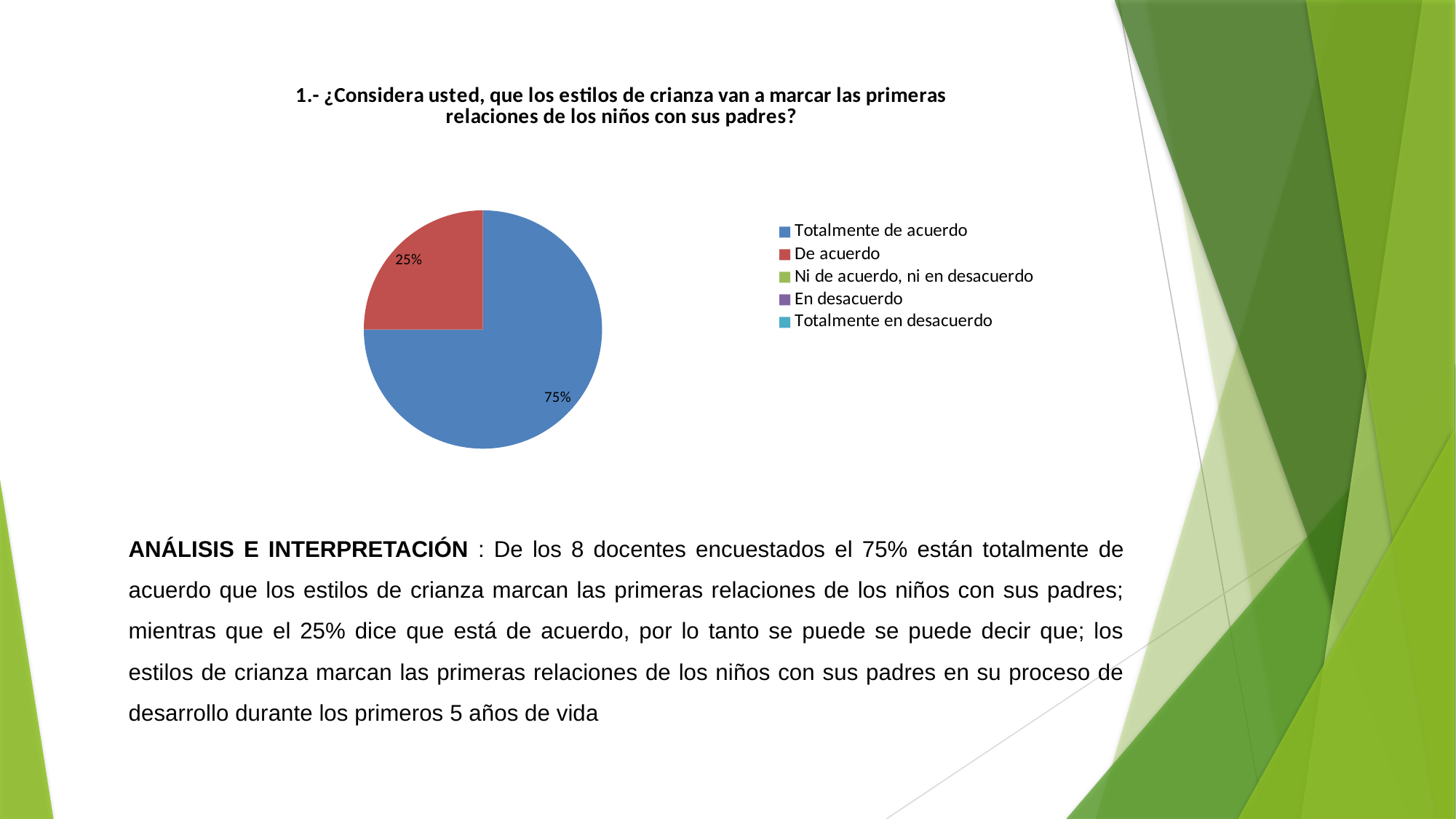
What share of the pie does "Totalmente de acuerdo" represent? 75% Which of the two visible slices is larger, "Totalmente de acuerdo" or "De acuerdo"? Totalmente de acuerdo How many entries does the legend list? 5 Which category has the largest slice of the pie? Totalmente de acuerdo Is the share for "De acuerdo" greater or less than 50%? less How many slices are visible in the pie chart? 2 What colour is the "De acuerdo" slice? Red What share of the pie does "De acuerdo" represent? 25% What is the difference in percentage points between the "Totalmente de acuerdo" slice and the "De acuerdo" slice? 50% What kind of chart is shown on the slide? Pie chart What colour is the "Totalmente de acuerdo" slice? Blue